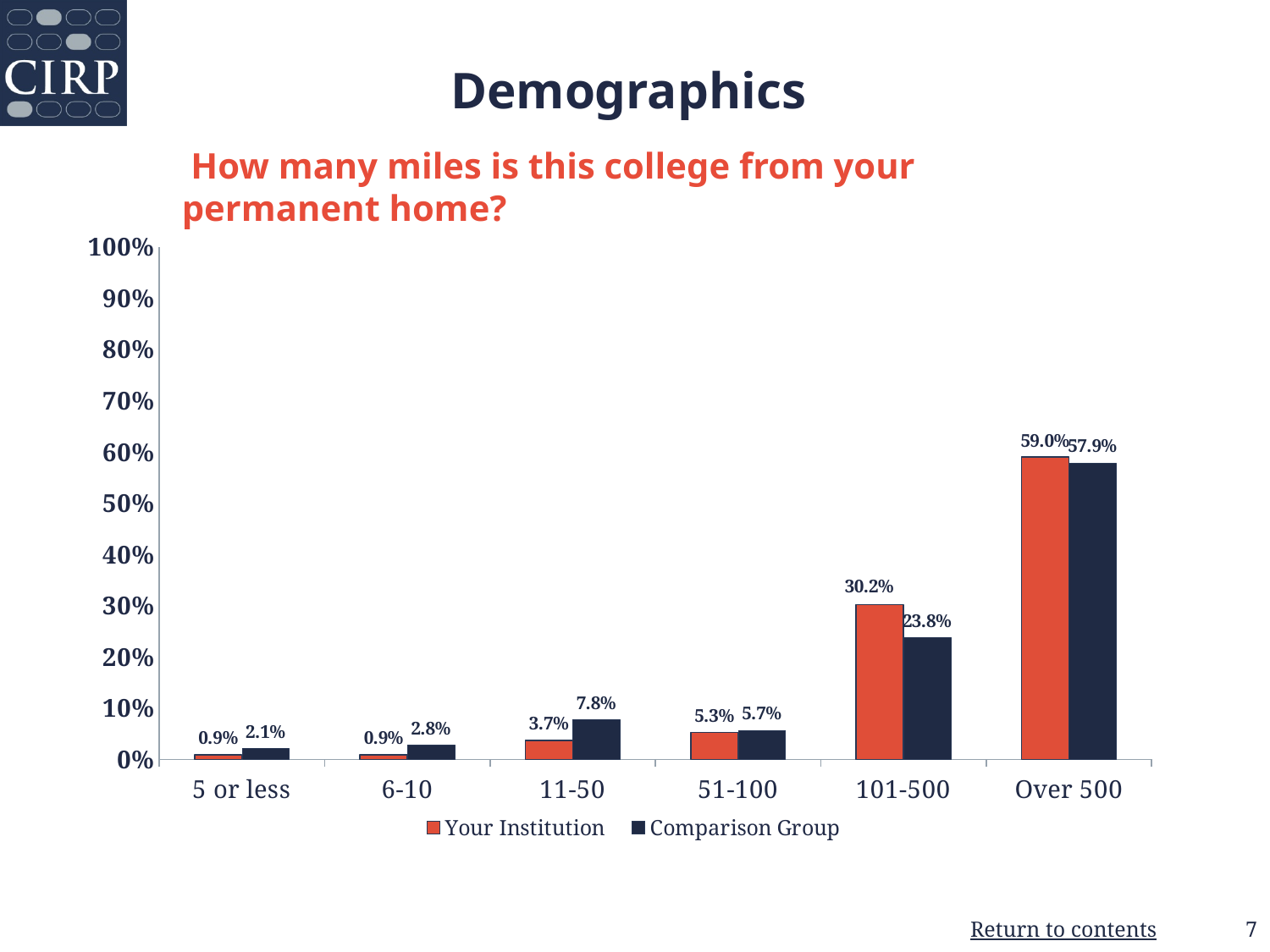
How many series does the legend list? 2 Which category has the lowest value for Comparison Group? 5 or less What is the value for Your Institution in the Over 500 category? 59.0% What is the difference between Your Institution and Comparison Group in the 101-500 category? 6.4% Is the value for Your Institution in the 101-500 category greater or less than 20%? greater What is the value for Comparison Group in the 101-500 category? 23.8% Which category has the highest value for Your Institution? Over 500 What question does the chart title ask? How many miles is this college from your permanent home? Which is larger in the 11-50 category, Your Institution or Comparison Group? Comparison Group What kind of chart is shown on the slide? bar chart How many categories are shown on the x axis? 6 What is the value for Comparison Group in the 11-50 category? 7.8%